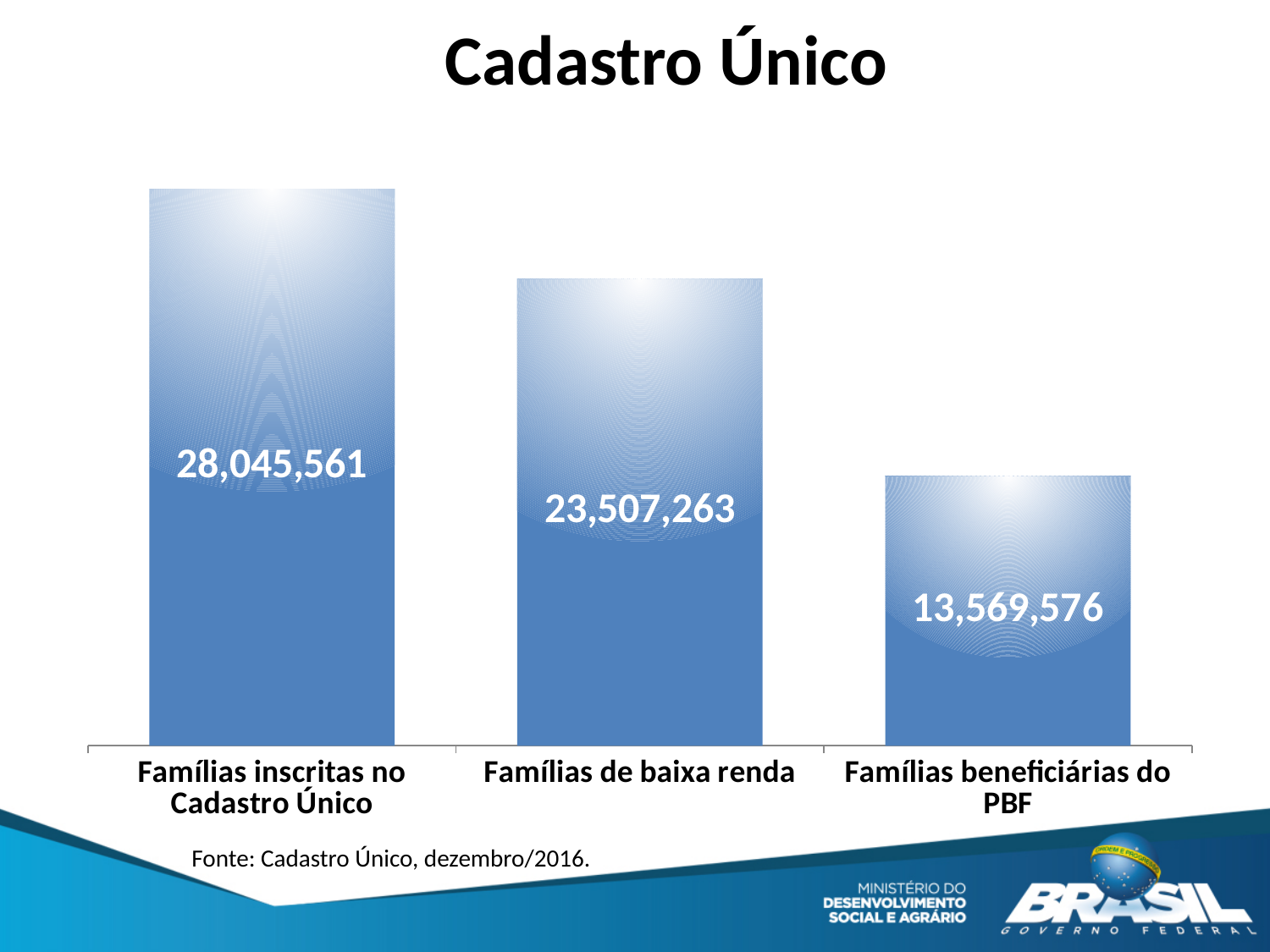
What is the value for Famílias inscritas no Cadastro Único? 28,045,561 What is the difference between Famílias inscritas no Cadastro Único and Famílias de baixa renda? 4,538,298 Which is larger, Famílias de baixa renda or Famílias beneficiárias do PBF? Famílias de baixa renda What is the difference between Famílias de baixa renda and Famílias beneficiárias do PBF? 9,937,687 Which category has the lowest value? Famílias beneficiárias do PBF How many categories are shown in the chart? 3 What is the value for Famílias beneficiárias do PBF? 13,569,576 Which category has the highest value? Famílias inscritas no Cadastro Único What is the value for Famílias de baixa renda? 23,507,263 What kind of chart is shown on the slide? Bar chart Do the values rise or fall from left to right across the categories? Fall What is the difference between Famílias inscritas no Cadastro Único and Famílias beneficiárias do PBF? 14,475,985